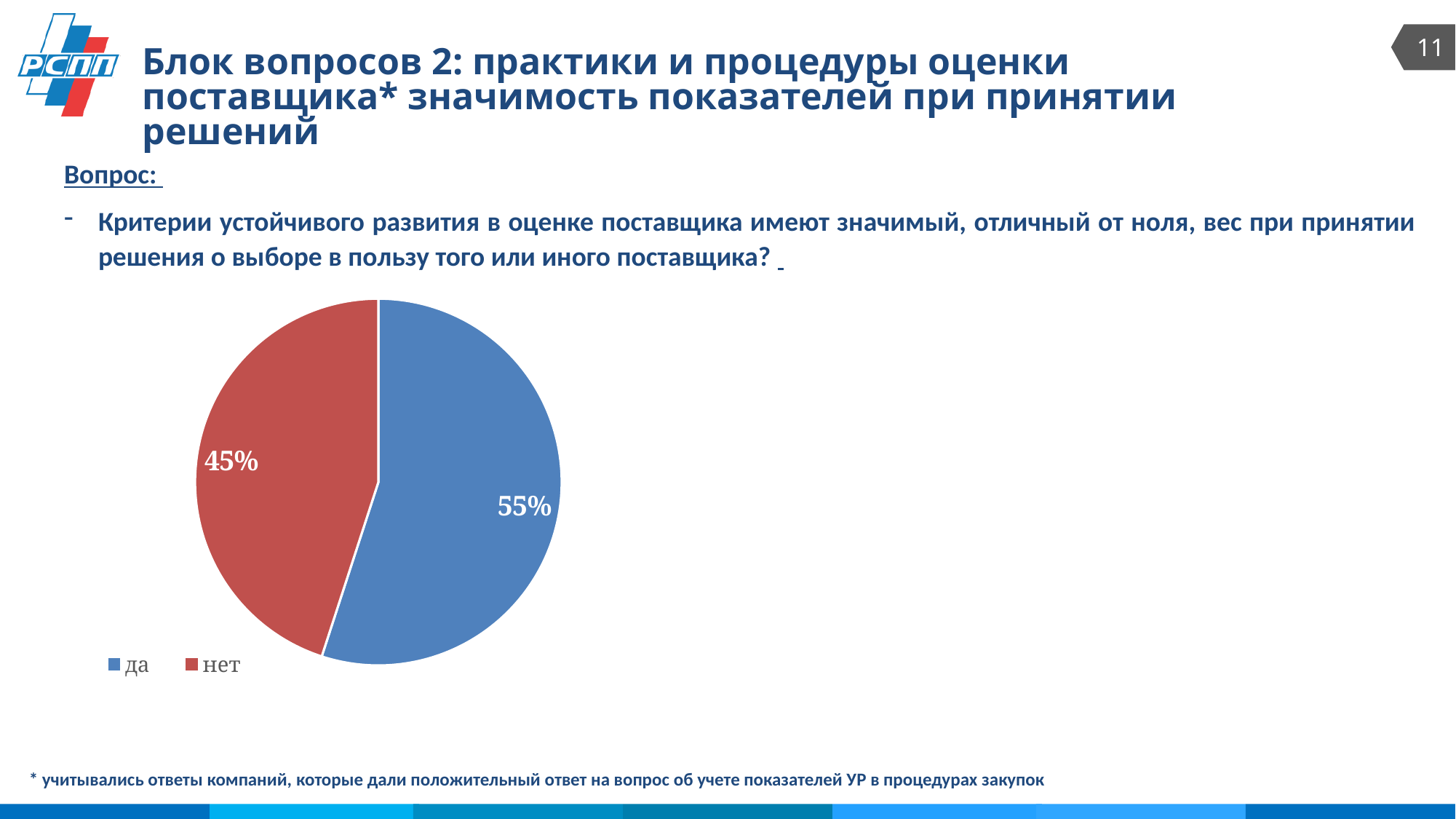
How many entries does the legend list? 2 What share of the pie does "да" take? 55% What colour is the "да" slice? blue Which slice is the largest? да Which is larger, the "да" slice or the "нет" slice? да What kind of chart is shown on the slide? pie chart Which slice is the smallest? нет How many slices does the pie chart have? 2 What colour is the "нет" slice? red What share of the pie does "нет" take? 45% What is the difference in percentage points between the "да" and "нет" slices? 10